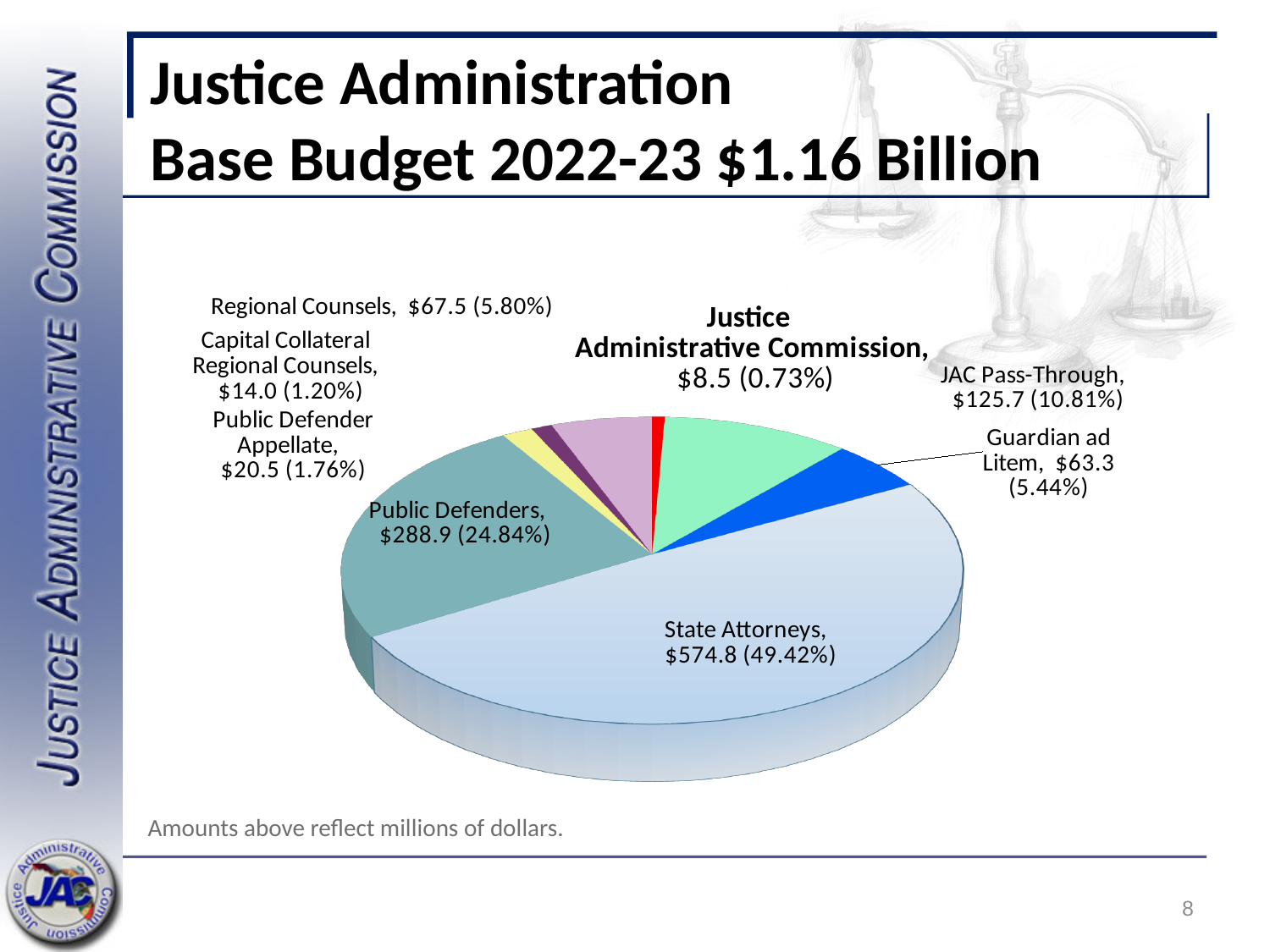
How many categories are shown in the pie chart? 8 What is the value for JAC Pass-Through? $125.7 What type of chart is shown on the slide? Pie chart What is the value for State Attorneys? $574.8 What share of the pie does Public Defenders represent? 24.84% What is the value for Guardian ad Litem? $63.3 Which category has the largest slice of the pie? State Attorneys What is the difference between the values for State Attorneys and Public Defenders? $285.9 Which category has the smallest slice of the pie? Justice Administrative Commission What share of the pie does Regional Counsels represent? 5.80% What is the value for Public Defenders? $288.9 Which is larger, the value for Regional Counsels or the value for Guardian ad Litem? Regional Counsels